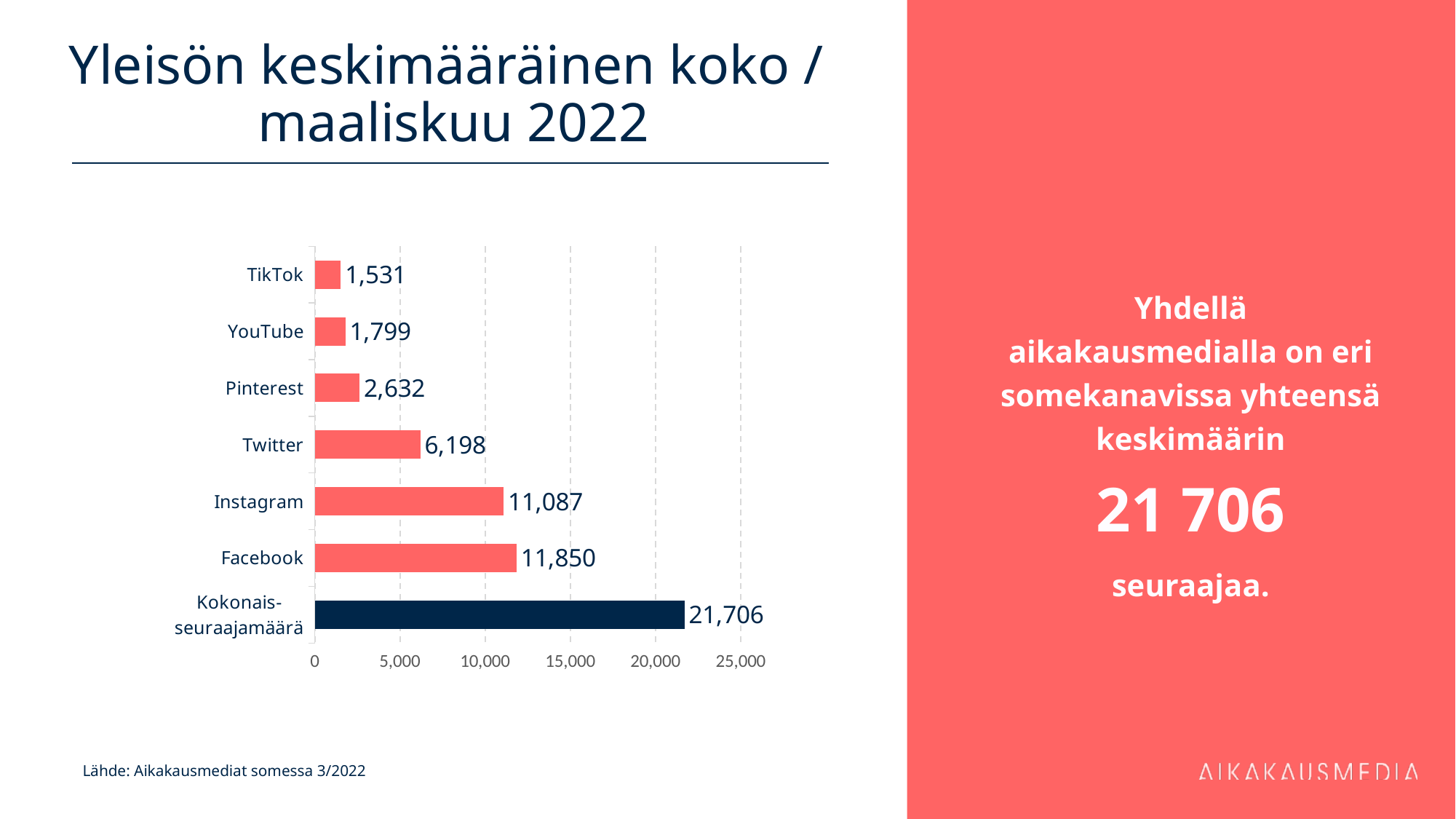
Which is larger, the value for Pinterest or the value for YouTube? Pinterest How many categories are shown in the chart? 7 What is the value for Facebook? 11,850 What is the value for TikTok? 1,531 What kind of chart is shown on the slide? bar chart Which category has the lowest value? TikTok What is the value for Twitter? 6,198 Which individual social media channel has the highest value? Facebook What is the difference between the values for Facebook and Instagram? 763 What is the value for Kokonais-seuraajamäärä? 21,706 Which bar is shown in a different colour (dark navy) from the others? Kokonais-seuraajamäärä Is the value for Twitter greater or less than 5,000? greater